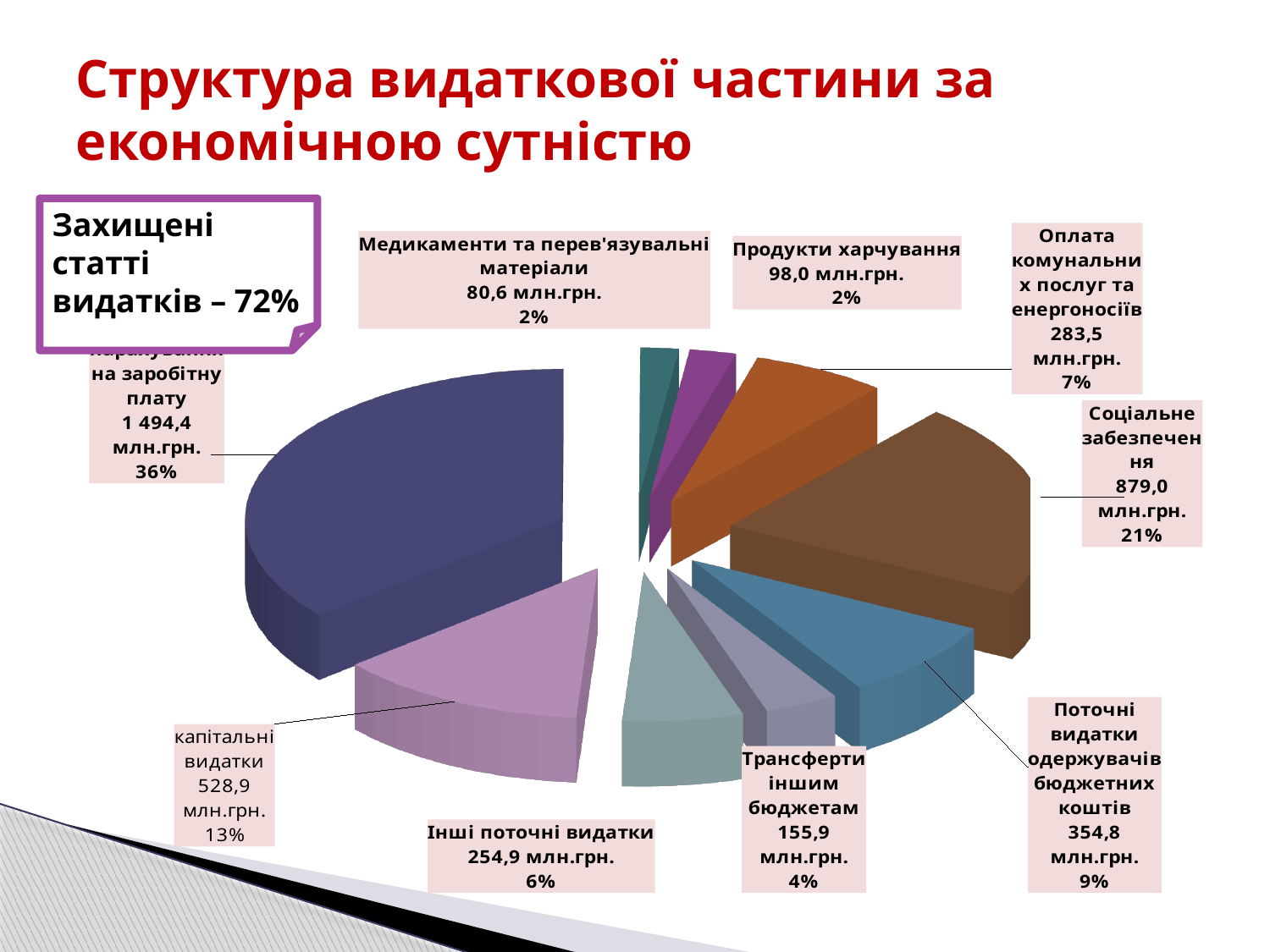
What is the difference in млн.грн. between Соціальне забезпечення and Оплата комунальних послуг та енергоносіїв? 595,5 млн.грн. Which is larger: Медикаменти та перев'язувальні матеріали or Продукти харчування? Продукти харчування How many slices does the pie chart have? 9 What is the title of the chart slide? Структура видаткової частини за економічною сутністю What share of the pie does капітальні видатки represent? 13% What is the value shown for Трансферти іншим бюджетам? 155,9 млн.грн. What is the value shown for Соціальне забезпечення? 879,0 млн.грн. What is the value shown for Оплата комунальних послуг та енергоносіїв? 283,5 млн.грн. What percentage share does the largest slice of the pie have? 36% What share of the pie does Соціальне забезпечення represent? 21% What is the difference in percentage points between the shares of Поточні видатки одержувачів бюджетних коштів and Інші поточні видатки? 3% What kind of chart is shown on the slide? pie chart